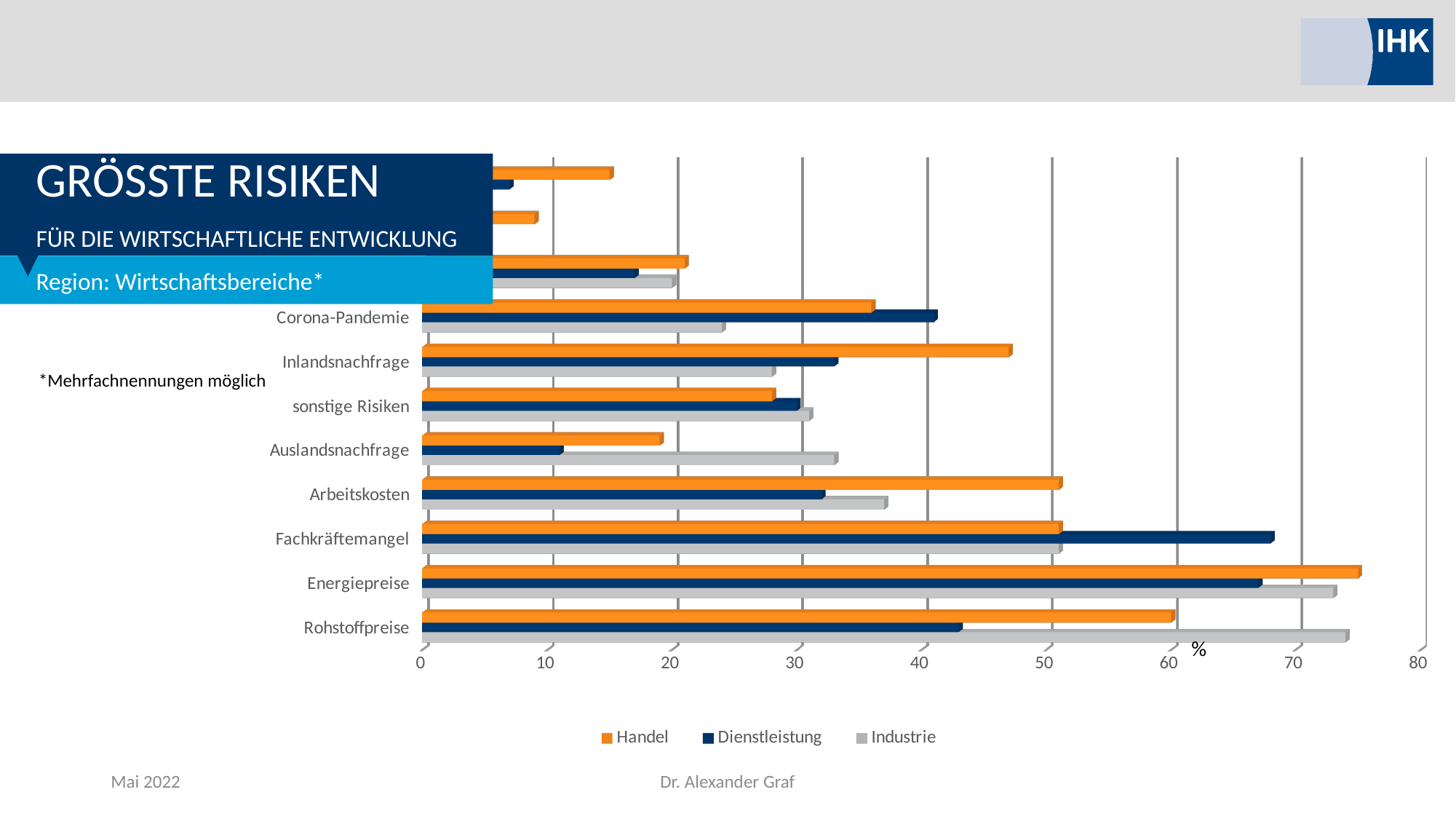
Is the Handel value for Inlandsnachfrage greater or less than 40? greater For Fachkräftemangel, which is larger: the Dienstleistung value or the Handel value? Dienstleistung What kind of chart is shown on the slide? bar chart For Corona-Pandemie, which is larger: the Dienstleistung value or the Industrie value? Dienstleistung Is the Handel value for Energiepreise greater or less than 70? greater For Auslandsnachfrage, which series has the lowest value? Dienstleistung For Rohstoffpreise, which is larger: the Industrie value or the Dienstleistung value? Industrie Is the Industrie value for Arbeitskosten greater or less than 30? greater Among the Handel bars, which category has the highest value? Energiepreise How many series does the legend list? 3 Which three series are listed in the legend? Handel, Dienstleistung, Industrie